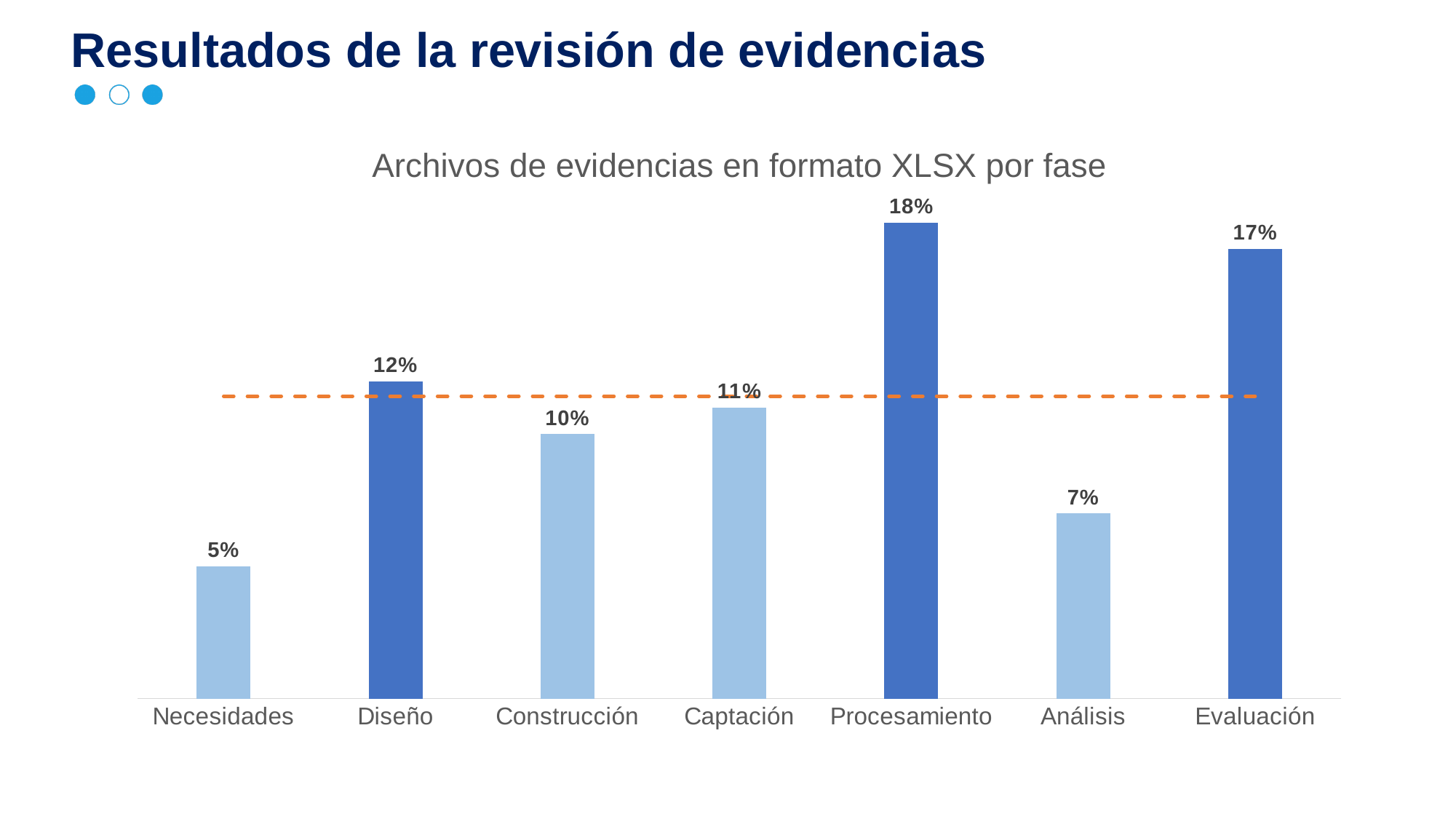
What is the difference between the values for Evaluación and Diseño? 5% What kind of chart is shown? Bar chart What is the value for Análisis? 7% Which is larger, the value for Construcción or the value for Análisis? Construcción What is the title of the chart? Archivos de evidencias en formato XLSX por fase Which phase has the lowest value? Necesidades Which phase has the highest value? Procesamiento What is the value for Procesamiento? 18% What is the value for Captación? 11% How many phases are shown on the x axis? 7 Which phases are drawn in the darker blue colour? Diseño, Procesamiento, Evaluación What is the value for Necesidades? 5%